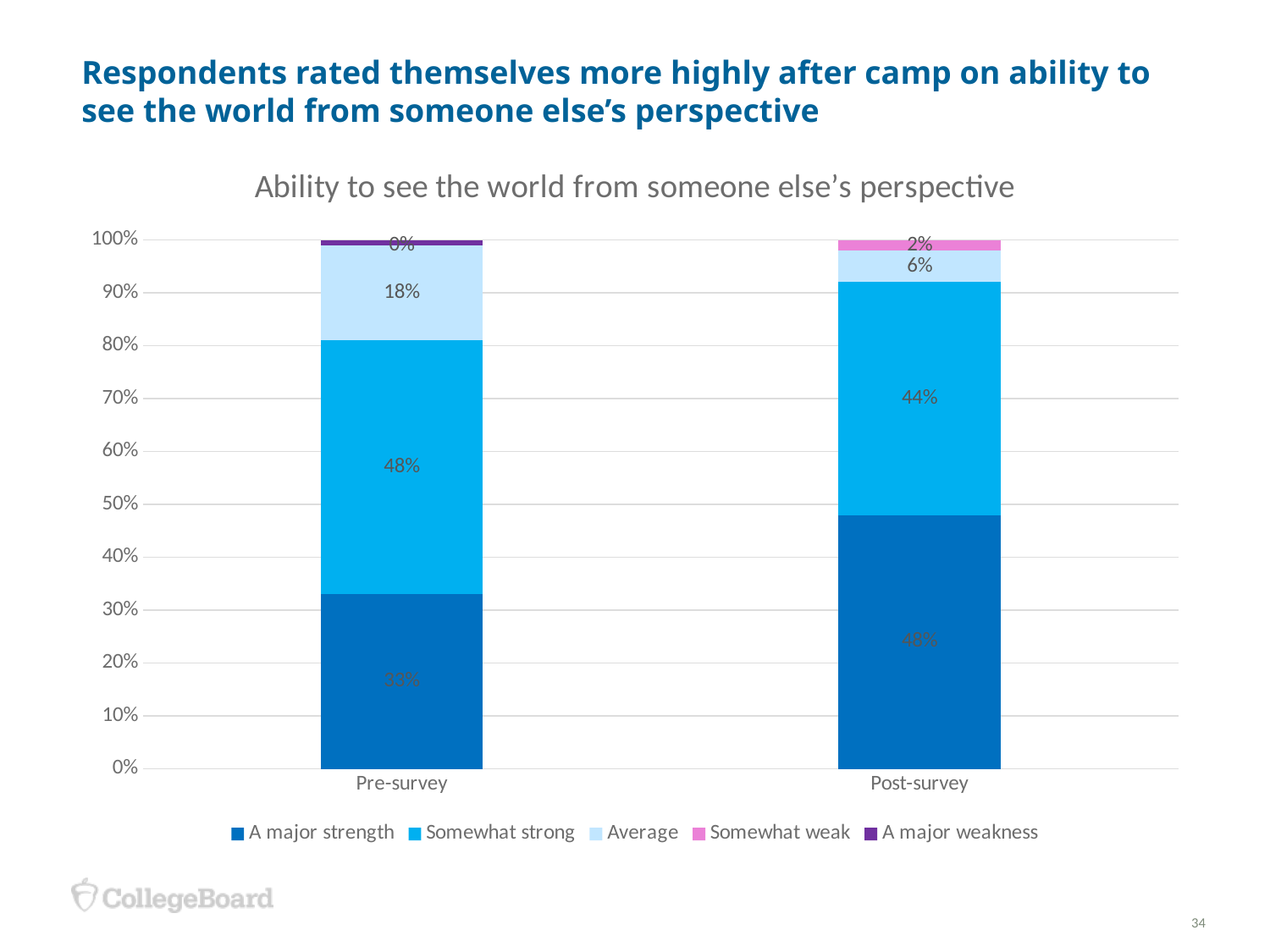
Which survey has the larger 'A major strength' share, Pre-survey or Post-survey? Post-survey What is the 'Average' value for Post-survey? 6% What is the 'Somewhat weak' value for Post-survey? 2% What is the title of the chart? Ability to see the world from someone else's perspective What percentage of Post-survey respondents rated the ability as 'A major strength'? 48% What is the 'Somewhat strong' value for Pre-survey? 48% What is the 'Average' value for Pre-survey? 18% How many series does the legend list? 5 By how many percentage points did the 'Average' share fall from Pre-survey to Post-survey? 12 percentage points How many categories are shown on the x axis? 2 What kind of chart is shown on the slide? Stacked bar chart What is the 'Somewhat strong' value for Post-survey? 44%